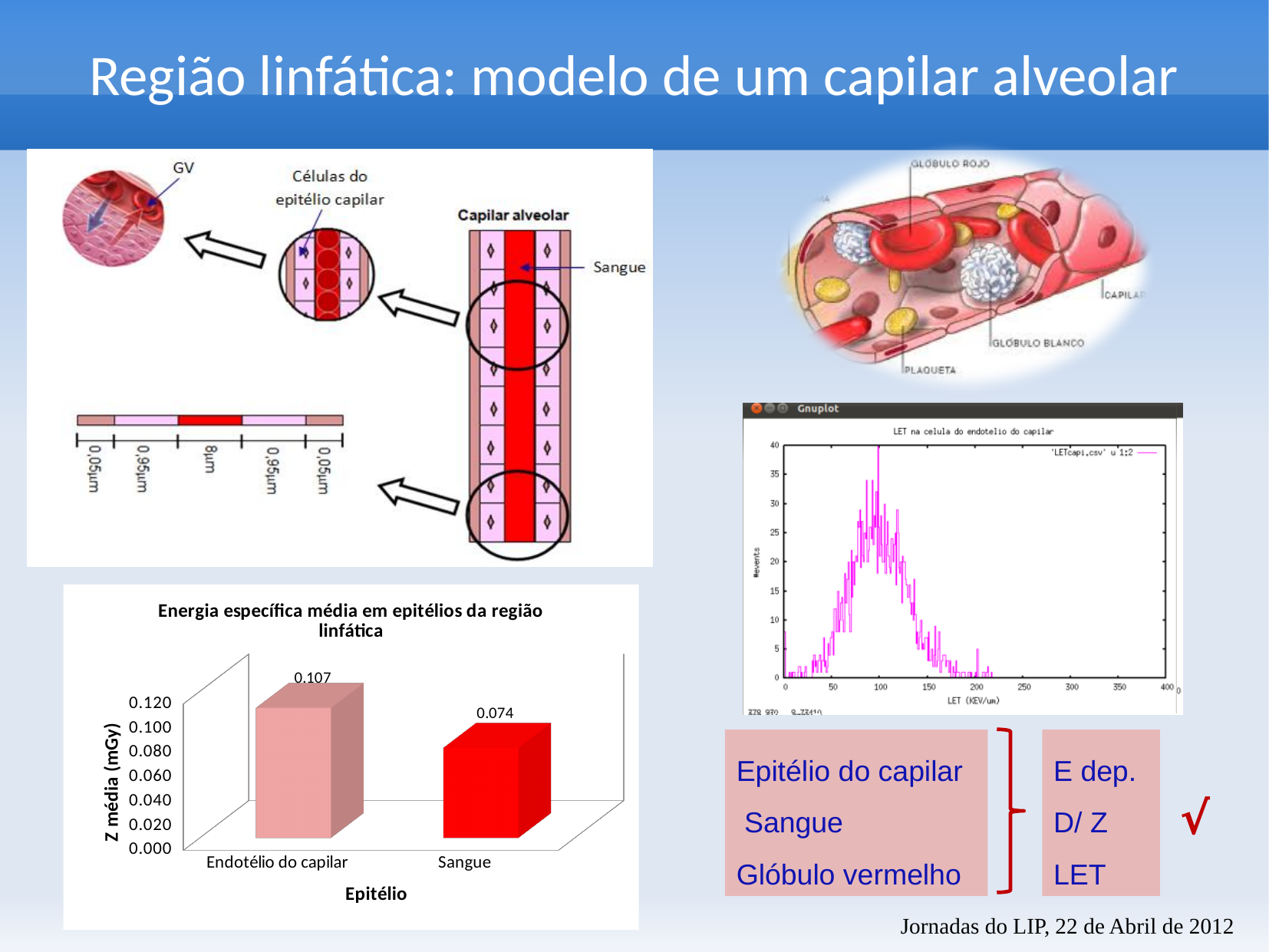
In the bar chart 'Energia específica média em epitélios da região linfática', what is the y-axis label? Z média (mGy) In the Gnuplot chart 'LET na celula do endotelio do capilar', what is the x-axis label? LET (KEV/um) In the bar chart 'Energia específica média em epitélios da região linfática', what is the value for Sangue? 0.074 In the bar chart 'Energia específica média em epitélios da região linfática', how many categories are shown on the x axis? 2 In the bar chart 'Energia específica média em epitélios da região linfática', what is the value for Endotélio do capilar? 0.107 In the bar chart 'Energia específica média em epitélios da região linfática', what is the difference between the values for Endotélio do capilar and Sangue? 0.033 In the bar chart 'Energia específica média em epitélios da região linfática', which category has the lowest Z média? Sangue In the bar chart 'Energia específica média em epitélios da região linfática', what is the x-axis label? Epitélio In the bar chart 'Energia específica média em epitélios da região linfática', is the value for Endotélio do capilar greater or less than 0.100? greater What kind of chart is 'Energia específica média em epitélios da região linfática'? Bar chart In the bar chart 'Energia específica média em epitélios da região linfática', which category has the highest Z média? Endotélio do capilar In the Gnuplot chart 'LET na celula do endotelio do capilar', is the peak number of events greater or less than 30? greater